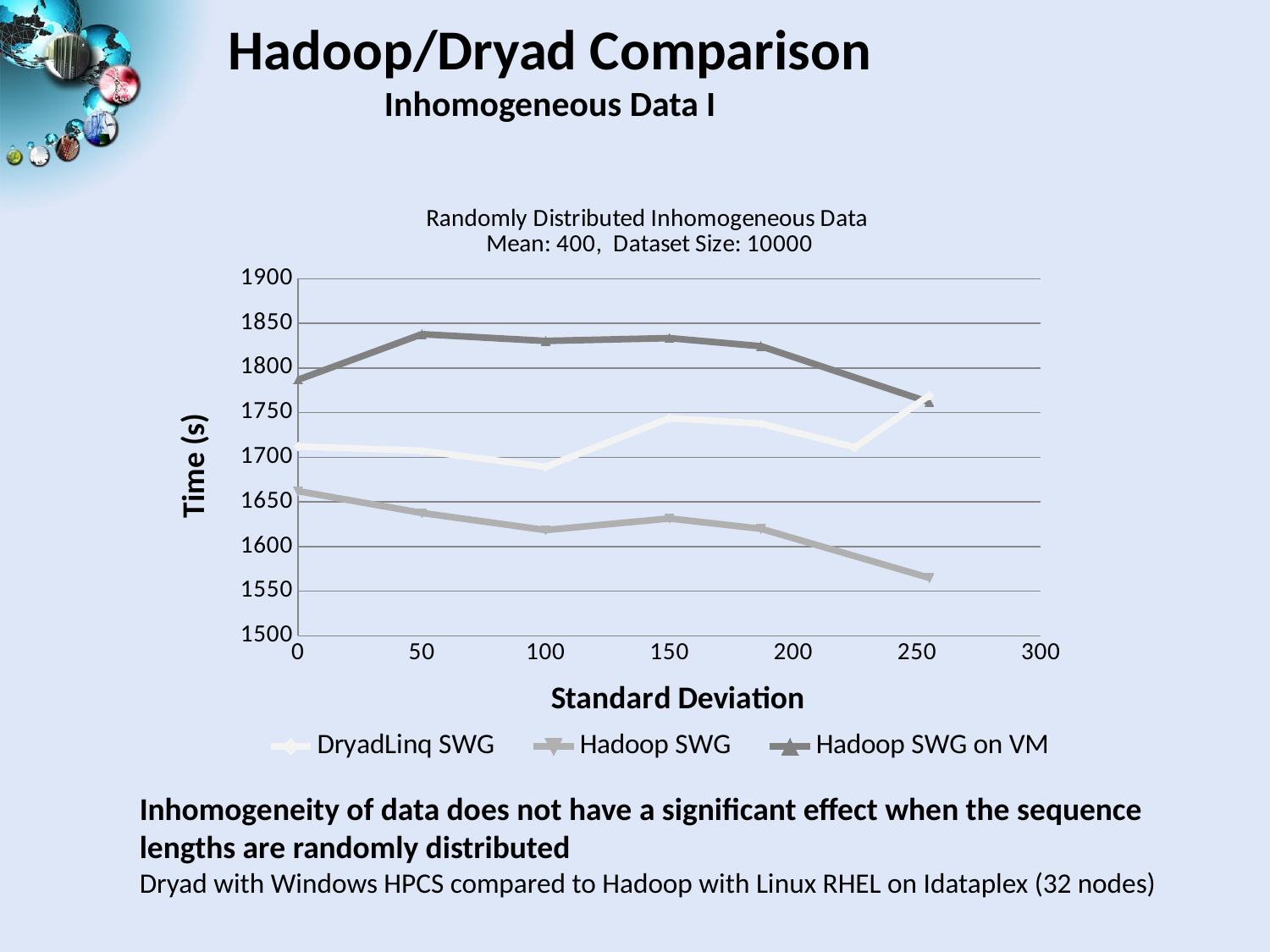
Does the Hadoop SWG series generally rise or fall as standard deviation increases? fall What is the label of the y axis? Time (s) Is the value for Hadoop SWG at a standard deviation of about 250 greater or less than 1600? less What kind of chart is shown on the slide? Line chart Is the value for Hadoop SWG on VM at a standard deviation of 50 greater or less than 1800? greater Which series has the lowest Time (s) values across the chart? Hadoop SWG Is the value for DryadLinq SWG at a standard deviation of 150 greater or less than 1700? greater At a standard deviation of 0, which is larger: Hadoop SWG on VM or Hadoop SWG? Hadoop SWG on VM How many series does the legend list? 3 Which series has the highest Time (s) values across the chart? Hadoop SWG on VM What is the label of the x axis? Standard Deviation